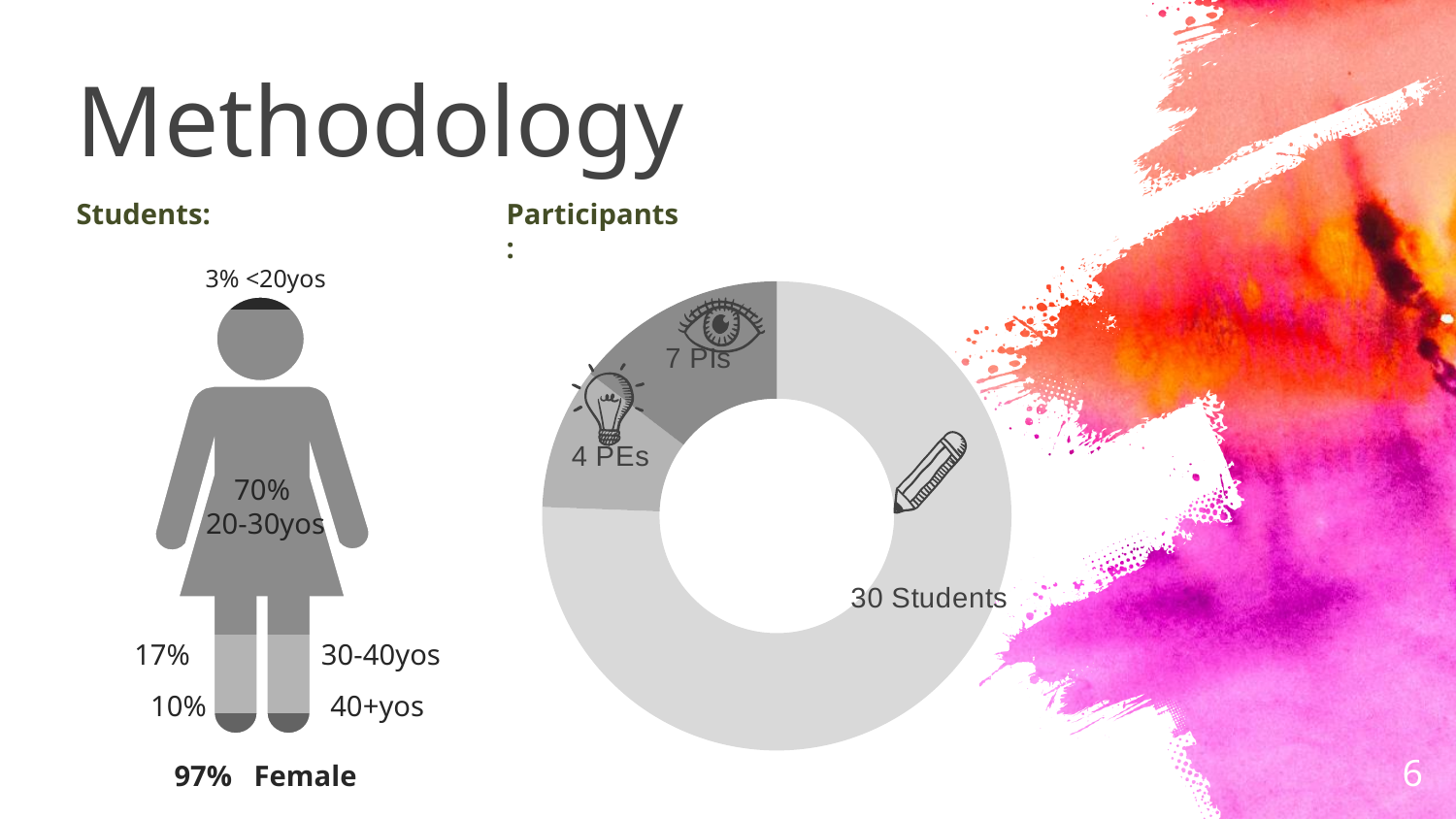
In the Participants chart, how many Students are there? 30 In the Participants chart, which group is the largest? Students In the Participants chart, how many PIs are there? 7 What is the total number of participants shown in the Participants chart? 41 In the Participants chart, which group is the smallest? PEs How many segments does the Participants chart have? 3 In the Participants chart, are there more PIs or PEs? PIs In the Participants chart, how many more Students are there than PIs? 23 In the Students figure on the left, what percentage of students are 20-30yos? 70% In the Participants chart, what is the difference between the number of PIs and PEs? 3 In the Participants chart, how many PEs are there? 4 What kind of chart is the Participants chart? Donut (pie) chart